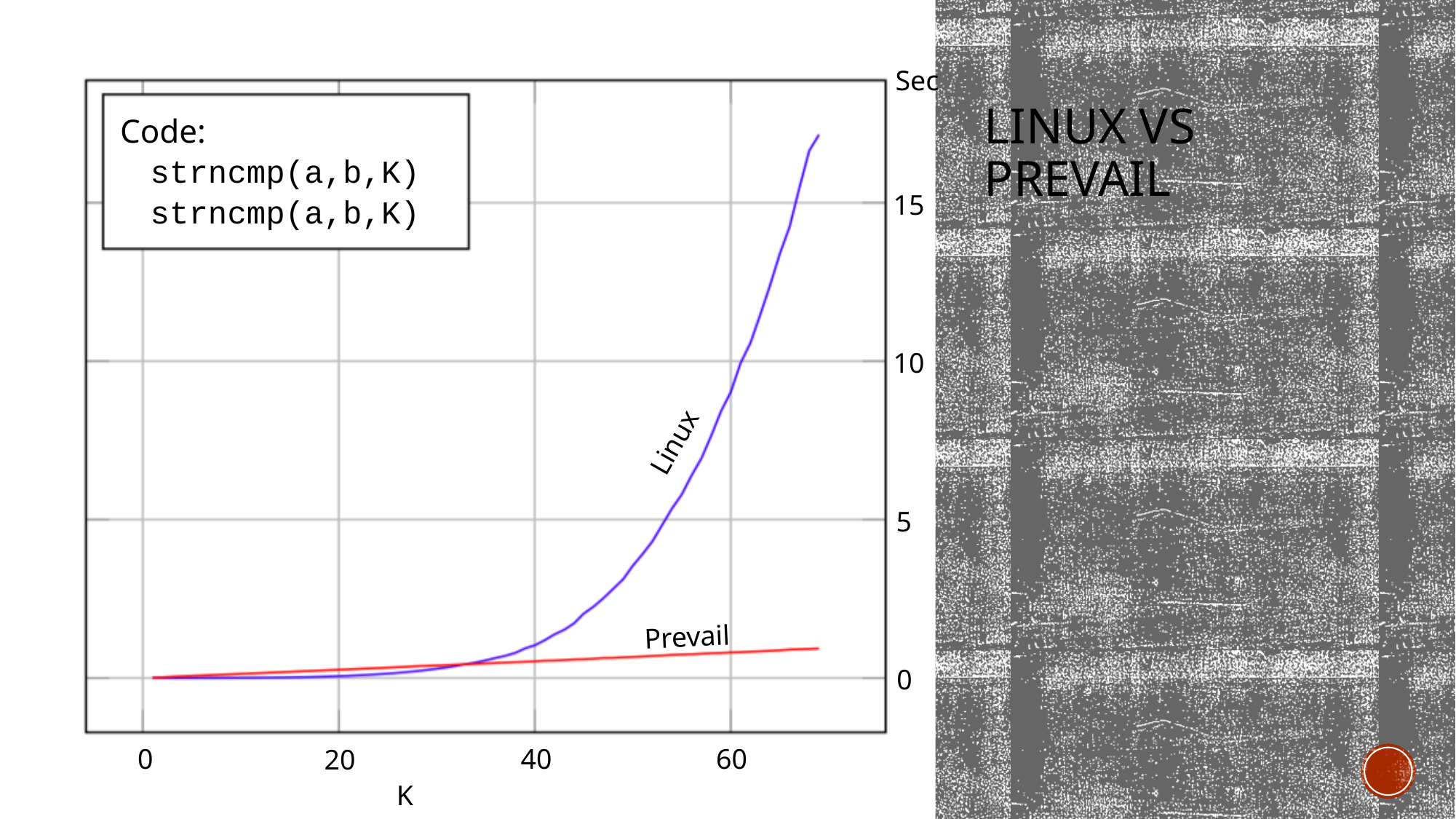
Does the Linux series rise or fall as K increases? rise Is the highest value reached by the Linux series greater or less than 15? greater What is the label of the x axis? K Which series reaches the highest value on the chart? Linux Is the value for Linux at K = 40 greater or less than 5? less At K = 60, which series has the larger value, Linux or Prevail? Linux Is the value for Linux at K = 60 greater or less than 5? greater What are the names of the two series plotted on the chart? Linux and Prevail What kind of chart is shown on the slide? line chart How many series are plotted on the chart? 2